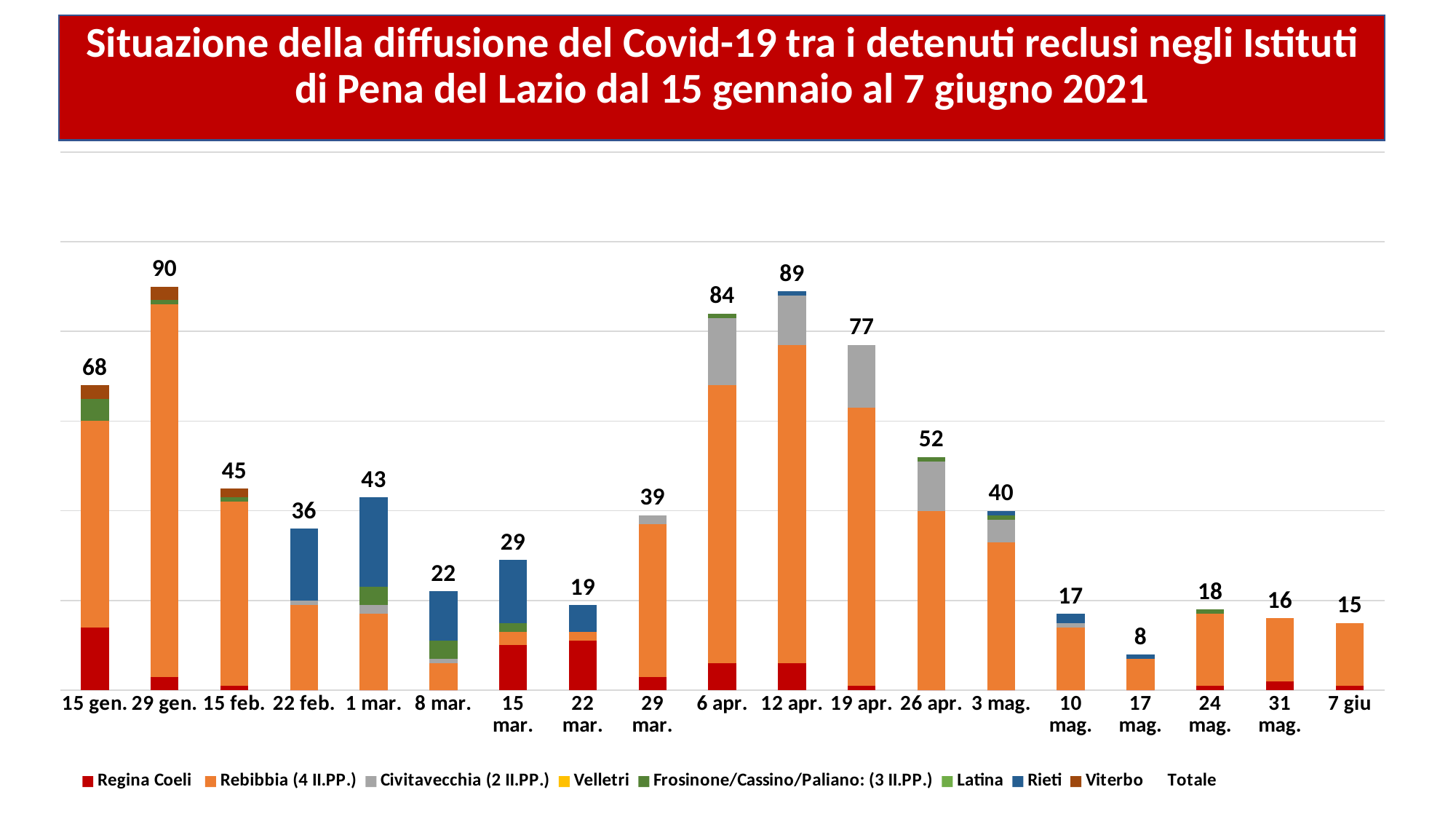
What is the difference between the totals for 6 apr. and 19 apr.? 7 Which date has the lowest total? 17 mag. What is the total value shown for 29 gen.? 90 Which has a larger total, 22 feb. or 1 mar.? 1 mar. Which date has the highest total? 29 gen. What kind of chart is shown? Stacked bar chart How many dates are shown on the x axis? 19 What is the total value shown for 12 apr.? 89 What is the total value shown for 17 mag.? 8 How many entries does the legend list? 9 Do the totals rise or fall from 12 apr. to 17 mag.? Fall What is the difference between the totals for 15 gen. and 15 feb.? 23